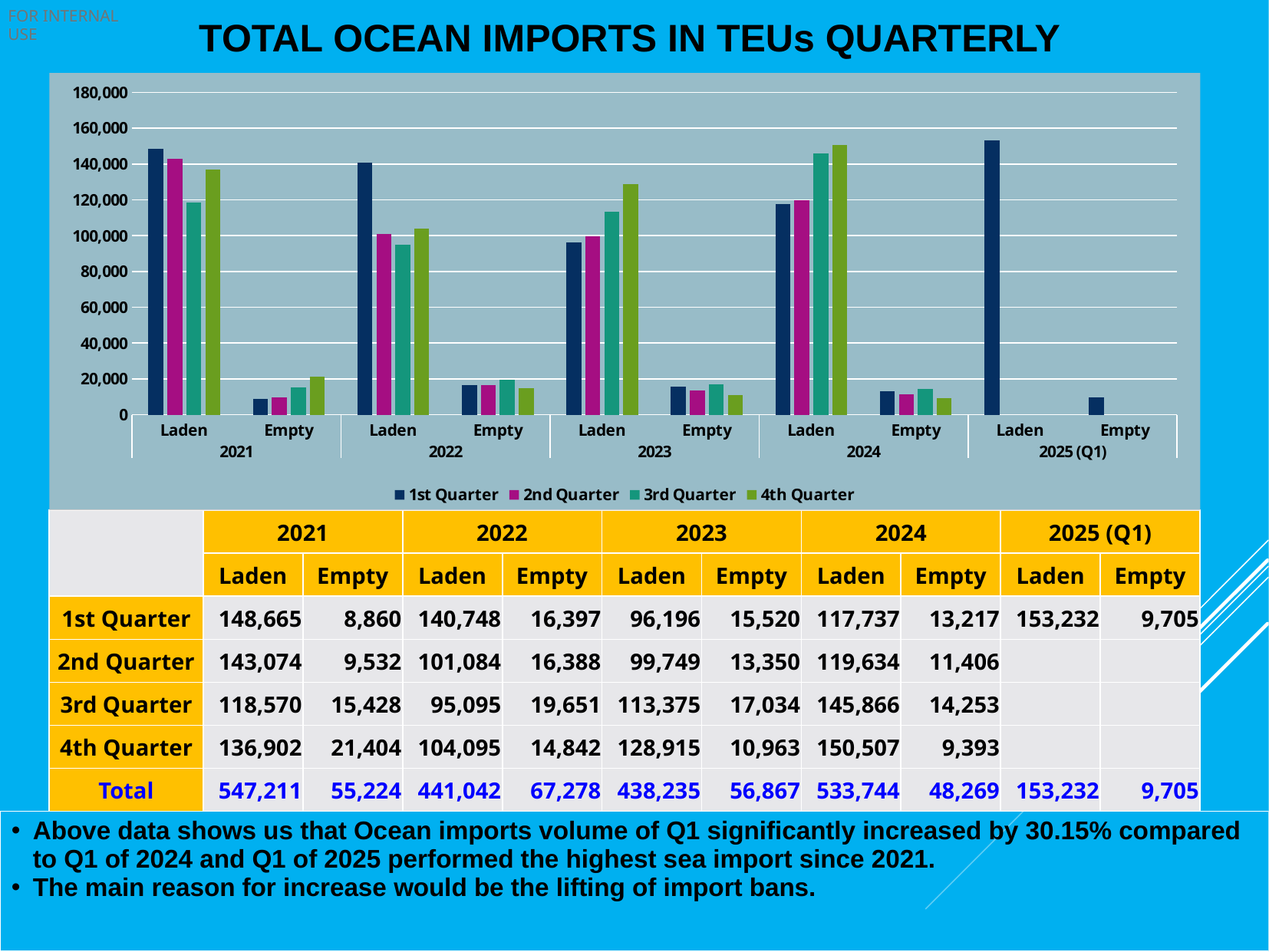
Which year has the highest 1st Quarter Laden value? 2025 (Q1) Is the 2nd Quarter Laden value for 2022 greater or less than 120,000? less What is the 4th Quarter Empty value for 2021? 21,404 How many year groups are shown along the x axis of the chart? 5 What colour represents the 1st Quarter series in the chart? Dark blue For 2024 Laden, which is larger: the 3rd Quarter or the 4th Quarter value? 4th Quarter What is the 1st Quarter Laden value for 2021? 148,665 How many series does the chart legend list? 4 What is the difference between the 1st Quarter Laden value for 2025 (Q1) and for 2024? 35,495 Do the Laden values for 2023 rise or fall from the 1st Quarter to the 4th Quarter? rise Which year has the lowest 1st Quarter Laden value? 2023 What kind of chart is shown on the slide? Bar chart